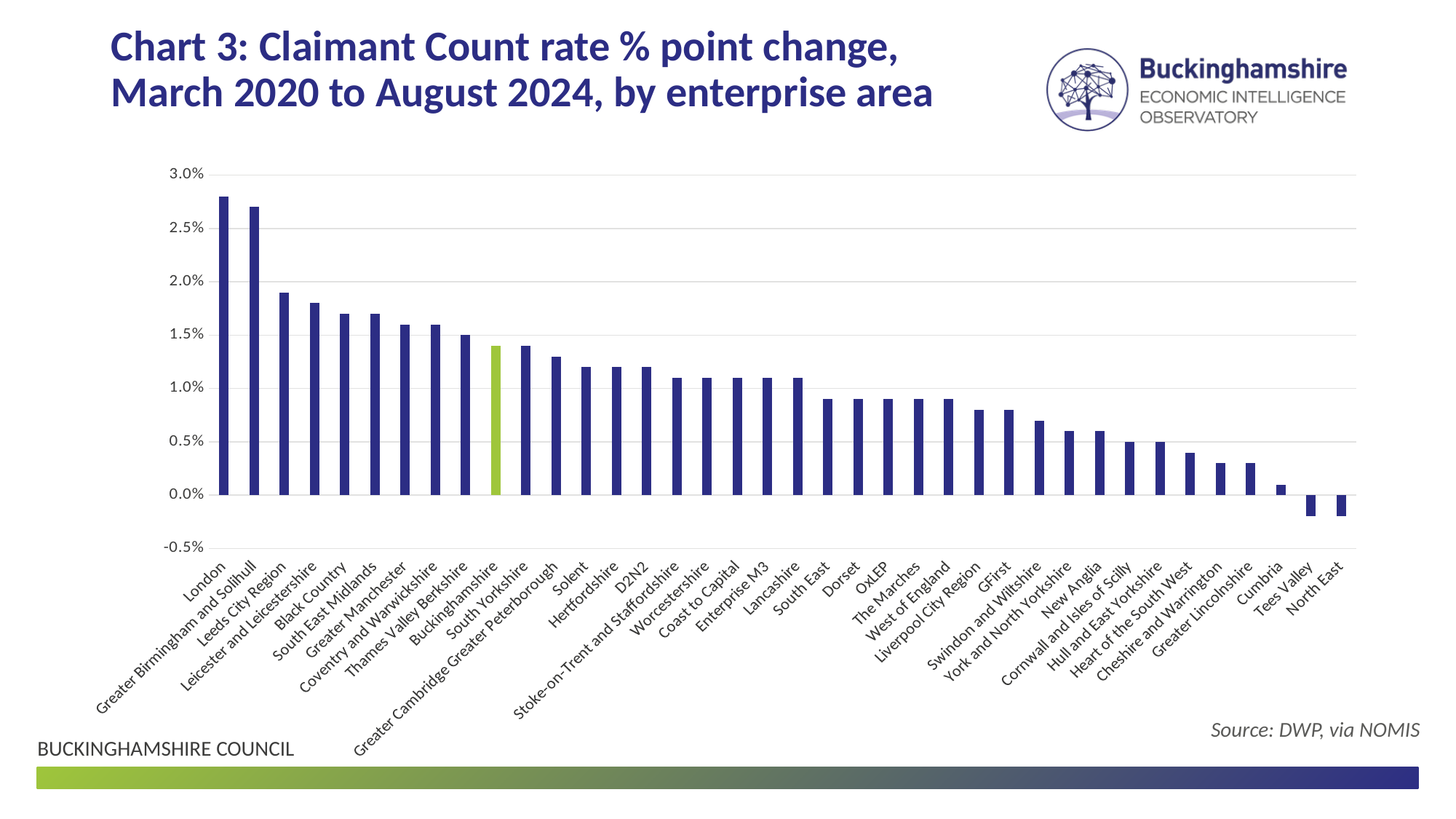
Is the value for Cumbria greater or less than 0.5%? less Is the value for London greater or less than 2.5%? greater What kind of chart is shown on the slide? Bar chart Which enterprise area's bar is coloured green rather than dark blue? Buckinghamshire Do the values rise or fall moving from left to right along the x axis? Fall Which has the larger value, Leeds City Region or Black Country? Leeds City Region Which has the larger value, Buckinghamshire or South East? Buckinghamshire Is the value for Leeds City Region greater or less than 2.0%? less How many enterprise areas are plotted on the chart? 38 Which enterprise area has the highest Claimant Count rate % point change? London